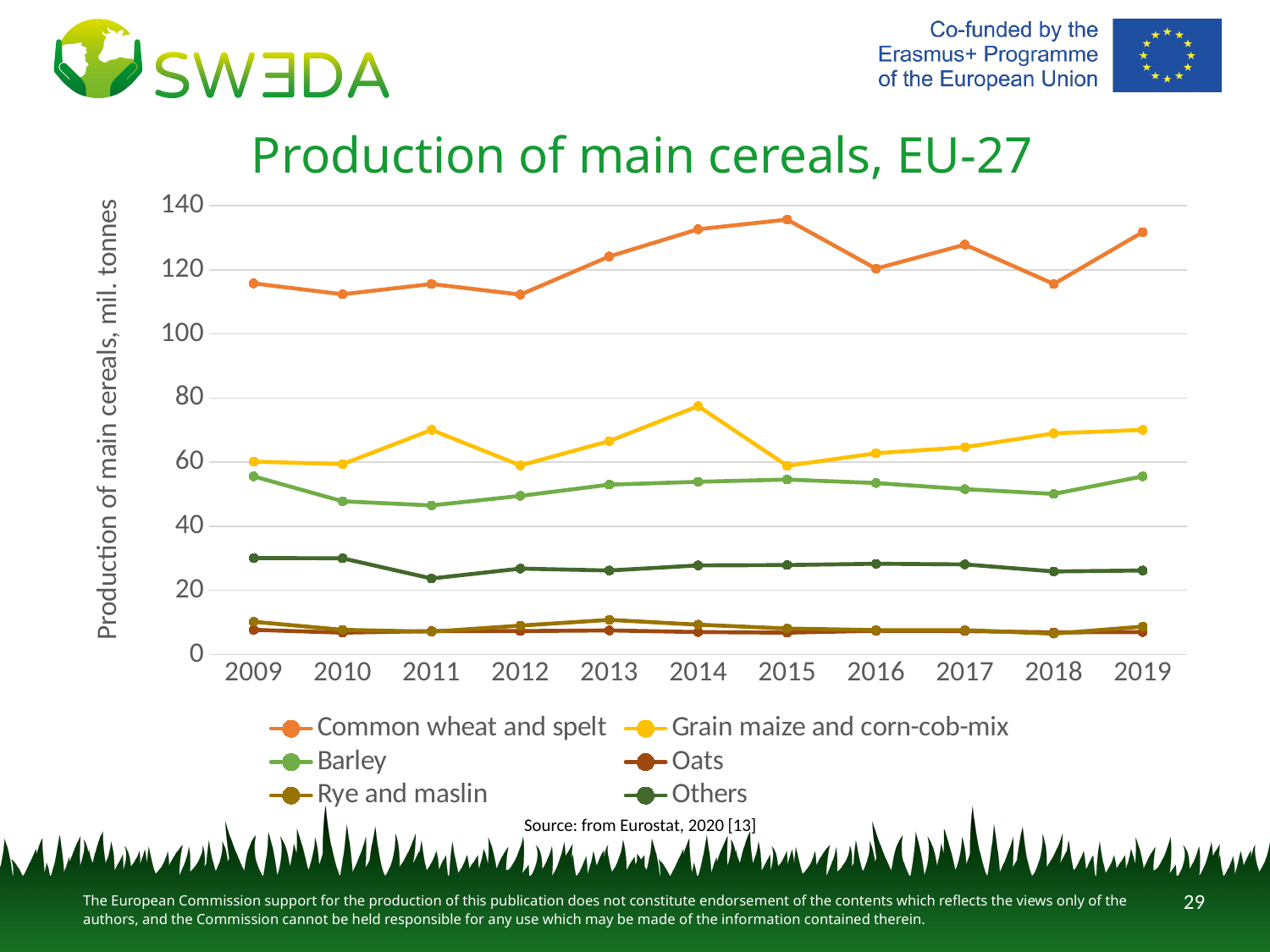
In 2015, which is larger: Barley or Others? Barley What kind of chart is shown on the slide? line chart Is the value for Common wheat and spelt in 2018 greater or less than 120? less Is the value for Common wheat and spelt in 2015 greater or less than 120? greater In which year does Grain maize and corn-cob-mix reach its highest value? 2014 Is the value for Grain maize and corn-cob-mix in 2011 greater or less than 60? greater In which year is the value for Barley lowest? 2011 How many series does the legend list? 6 How many years are plotted along the x axis? 11 Does the value for Common wheat and spelt rise or fall from 2012 to 2015? rise Which series has the highest values across all years? Common wheat and spelt